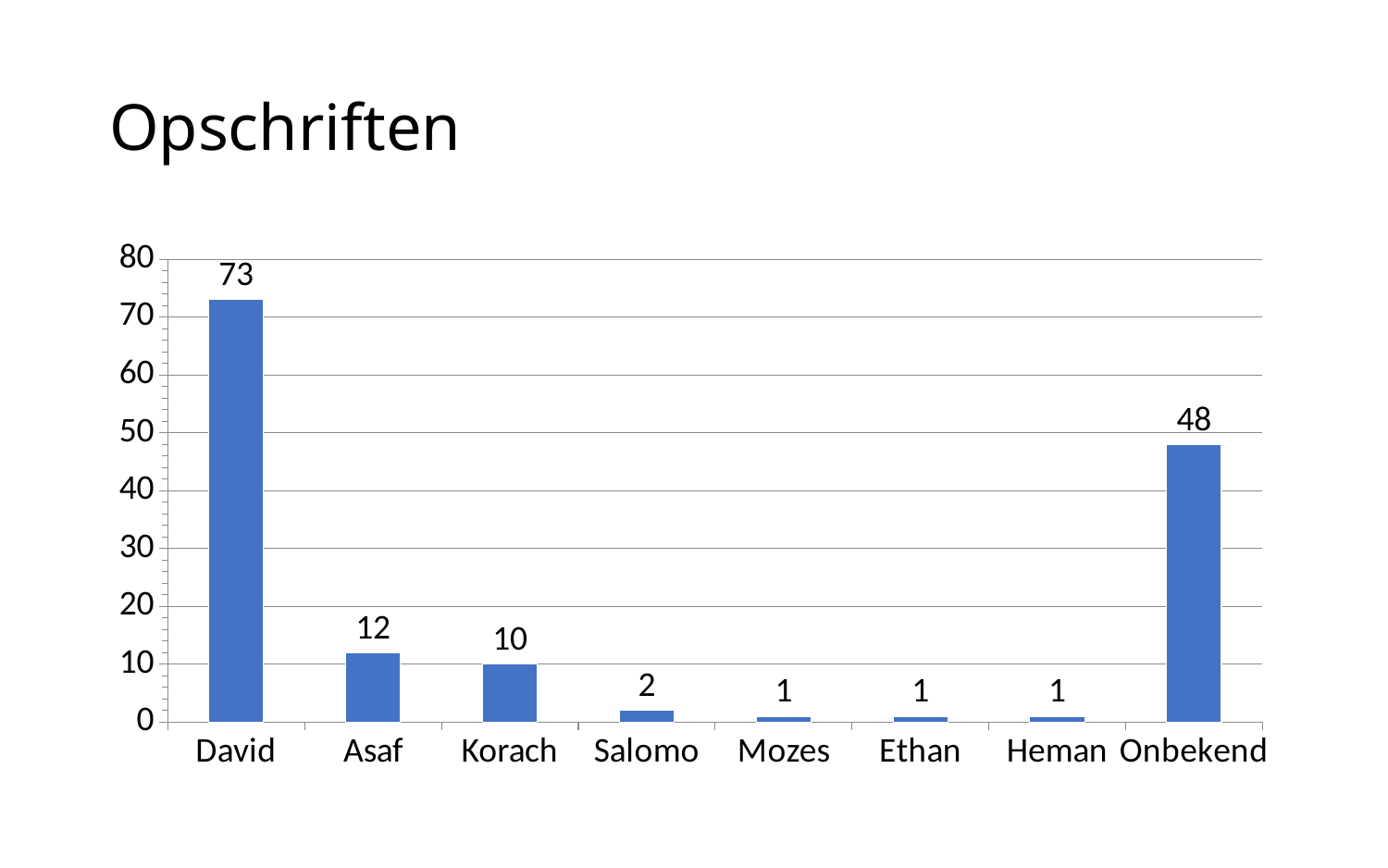
What is the title of the slide? Opschriften What is the value for David? 73 What is the difference between the values for Asaf and Korach? 2 How many categories have a value of 1? 3 What is the value for Onbekend? 48 Is the value for Onbekend greater or less than 40? greater What kind of chart is shown on the slide? bar chart Which category has the highest value? David Which is larger, the value for Asaf or the value for Salomo? Asaf What is the difference between the values for David and Onbekend? 25 How many categories are shown on the x axis? 8 What is the value for Korach? 10